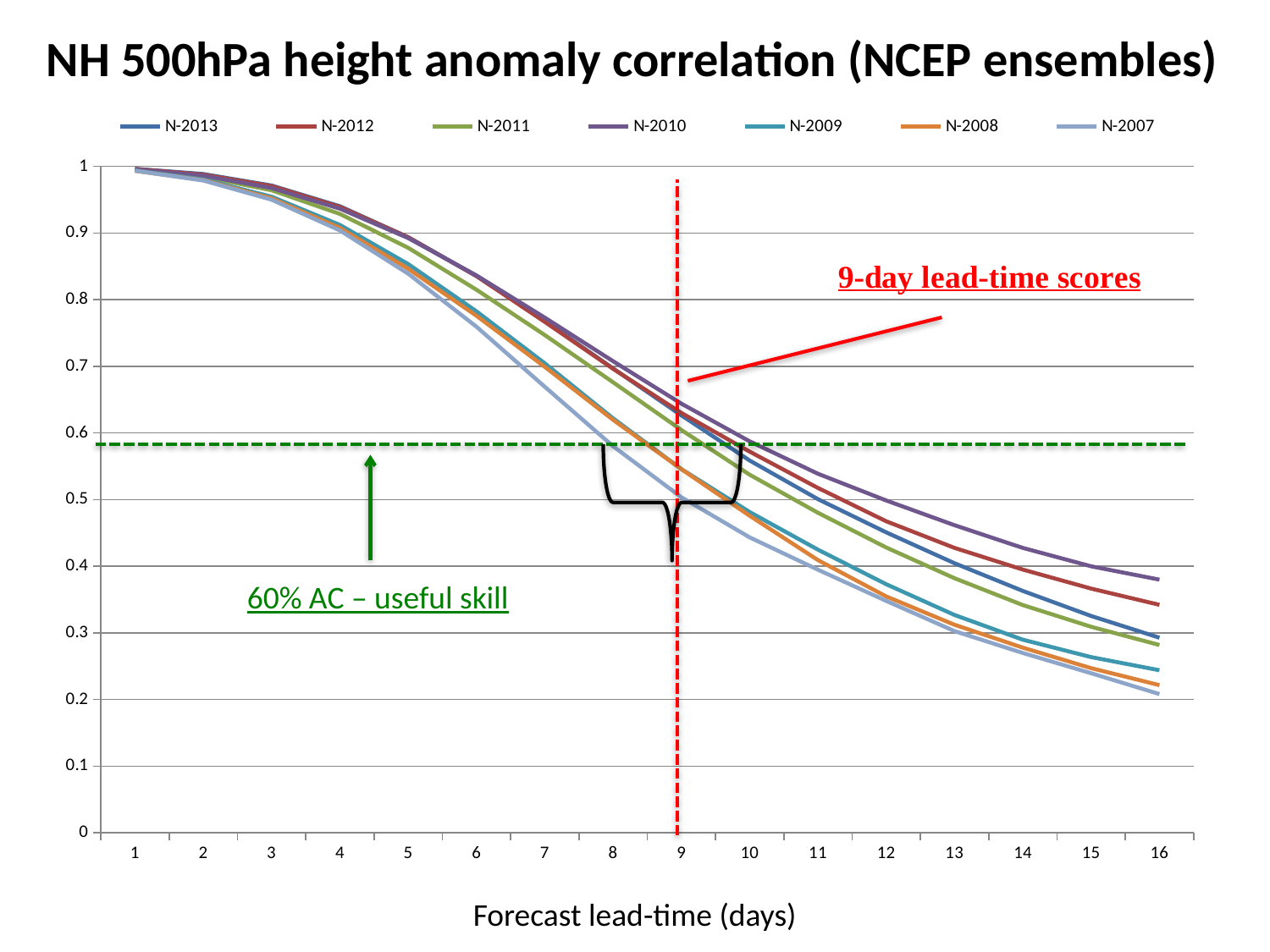
What kind of chart is shown on the slide? line chart How many series does the legend list? 7 Which series has the highest value at a lead-time of 16 days? N-2010 What is the label of the x axis? Forecast lead-time (days) Is the value for N-2007 at a lead-time of 16 days greater or less than 0.3? less Is the value for N-2007 at a lead-time of 9 days greater or less than 0.6? less At a lead-time of 16 days, which is larger: N-2012 or N-2013? N-2012 What is the title of the chart? NH 500hPa height anomaly correlation (NCEP ensembles) Is the value for N-2010 at a lead-time of 16 days greater or less than 0.3? greater How many forecast lead-time points are plotted along the x axis? 16 Do the anomaly correlation values rise or fall as forecast lead-time increases? fall